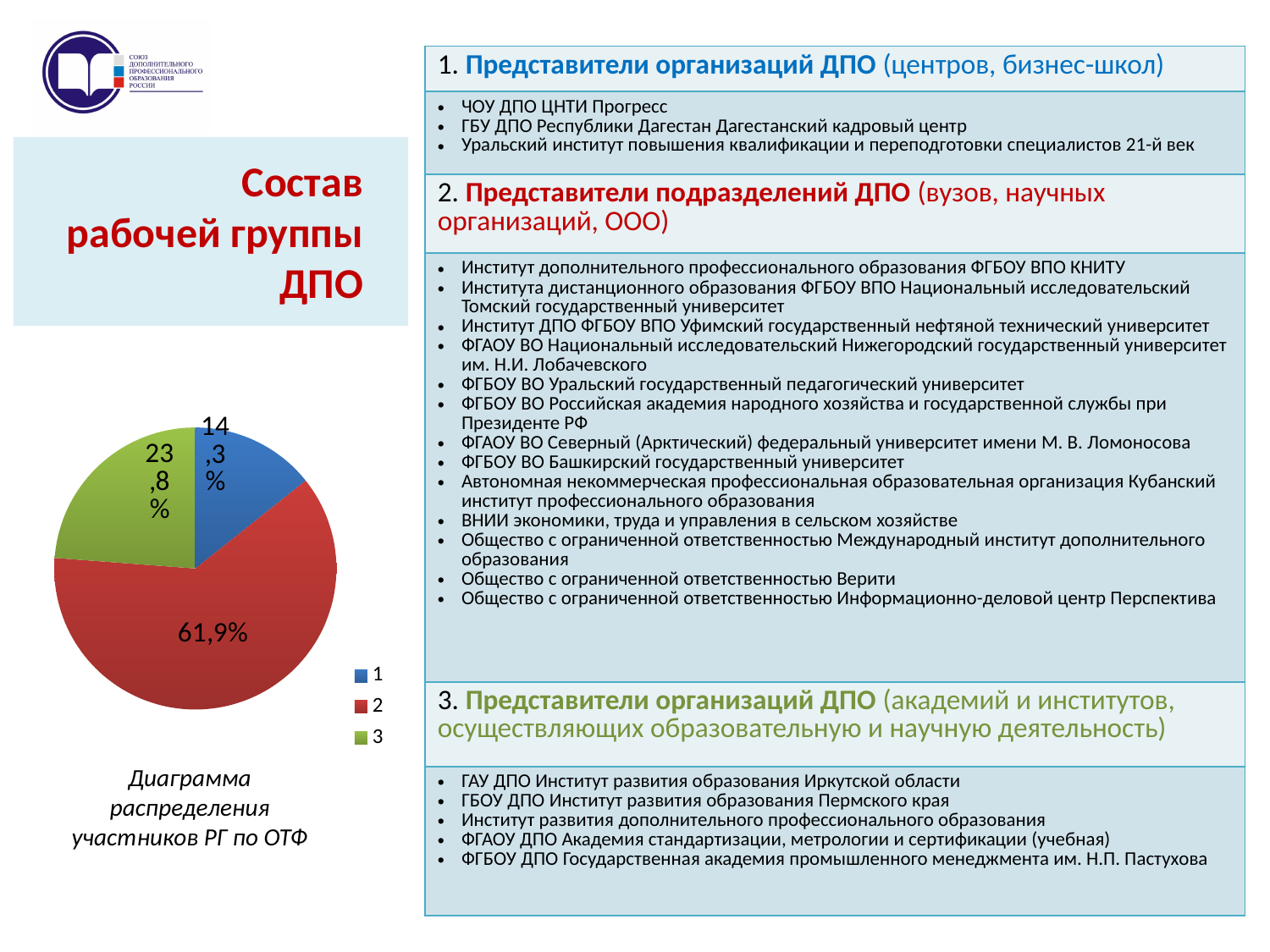
How many entries does the legend of the pie chart list? 3 What is the value shown for slice 2 in the pie chart? 61,9% What is the value shown for slice 1 in the pie chart? 14,3% Which is larger in the pie chart, slice 3 or slice 1? 3 Which slice of the pie chart is the largest? 2 What type of chart is shown on the slide? pie chart Which slice of the pie chart is the smallest? 1 What is the difference between the values of slice 3 and slice 1 in the pie chart? 9,5% How many slices does the pie chart have? 3 What is the difference between the values of slice 2 and slice 3 in the pie chart? 38,1% What colour is slice 2 in the pie chart? red What is the value shown for slice 3 in the pie chart? 23,8%